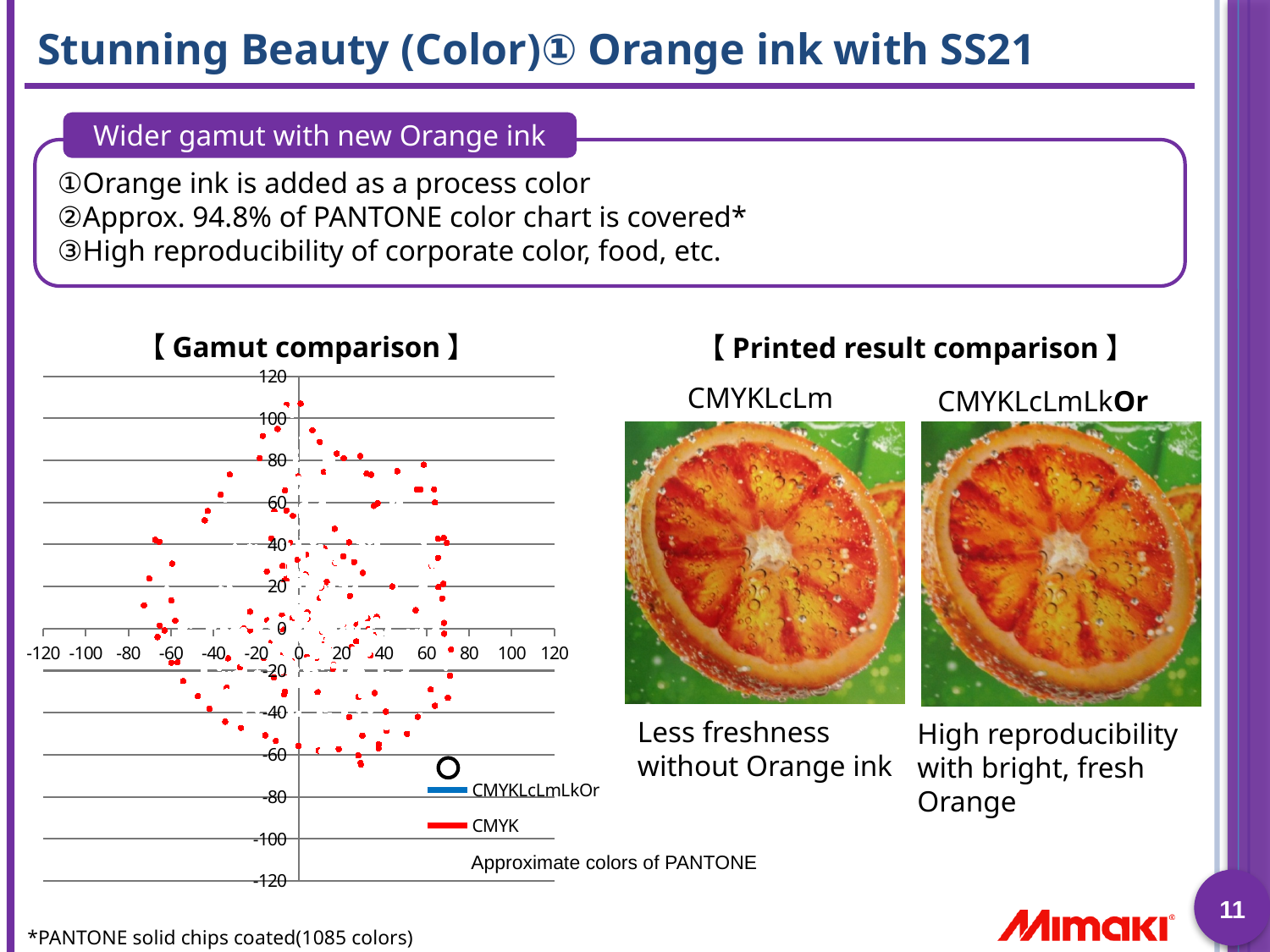
In the Gamut comparison chart, what are the two labelled legend entries? CMYKLcLmLkOr and CMYK In the Gamut comparison chart, is the highest plotted point greater or less than 100 on the vertical axis? greater In the Gamut comparison chart, what is the lowest value shown on the horizontal axis? -120 In the Gamut comparison chart, what is the highest value shown on the vertical axis? 120 In the Gamut comparison chart, is the leftmost plotted point greater or less than -80 on the horizontal axis? greater What is the title of the chart on the left side of the slide? Gamut comparison In the Gamut comparison chart, is the lowest plotted point greater or less than -80 on the vertical axis? greater In the Gamut comparison chart, how many tick labels are printed along the horizontal axis? 13 What kind of chart is shown under the heading 【Gamut comparison】? scatter chart In the Gamut comparison chart, what colour are the plotted data points? red